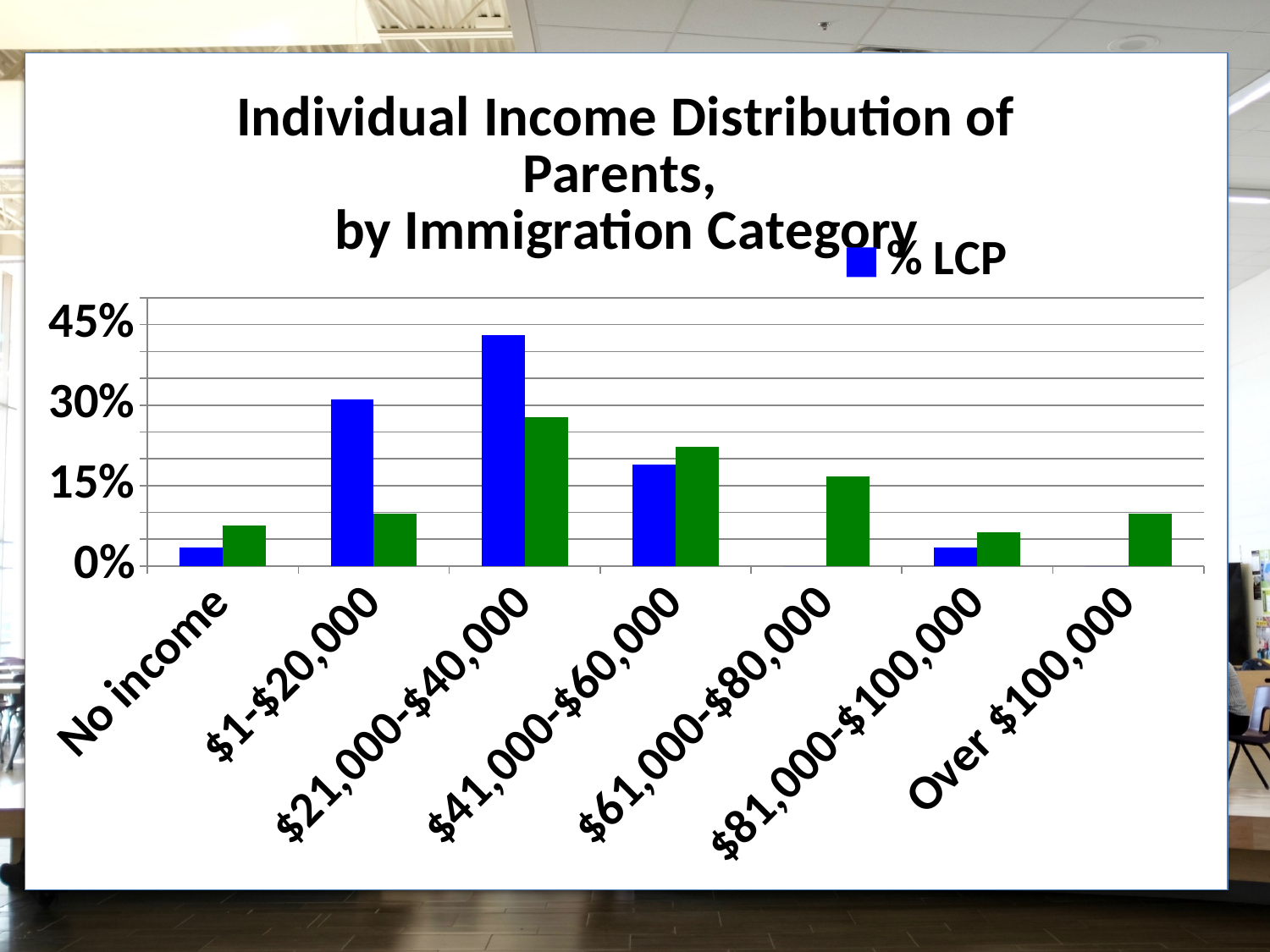
Is the % LCP value for No income greater or less than 15%? less Which income category has the highest % LCP value? $21,000-$40,000 Is the % LCP value for $21,000-$40,000 greater or less than 30%? greater For the $1-$20,000 category, which bar is taller, the blue % LCP bar or the green bar? The blue % LCP bar How many income categories are shown on the x axis? 7 Is the % LCP value for $41,000-$60,000 greater or less than 15%? greater Which series do the blue bars represent? % LCP For the No income category, which bar is taller, the blue % LCP bar or the green bar? The green bar What is the title of the chart? Individual Income Distribution of Parents, by Immigration Category What kind of chart is shown on the slide? Bar chart